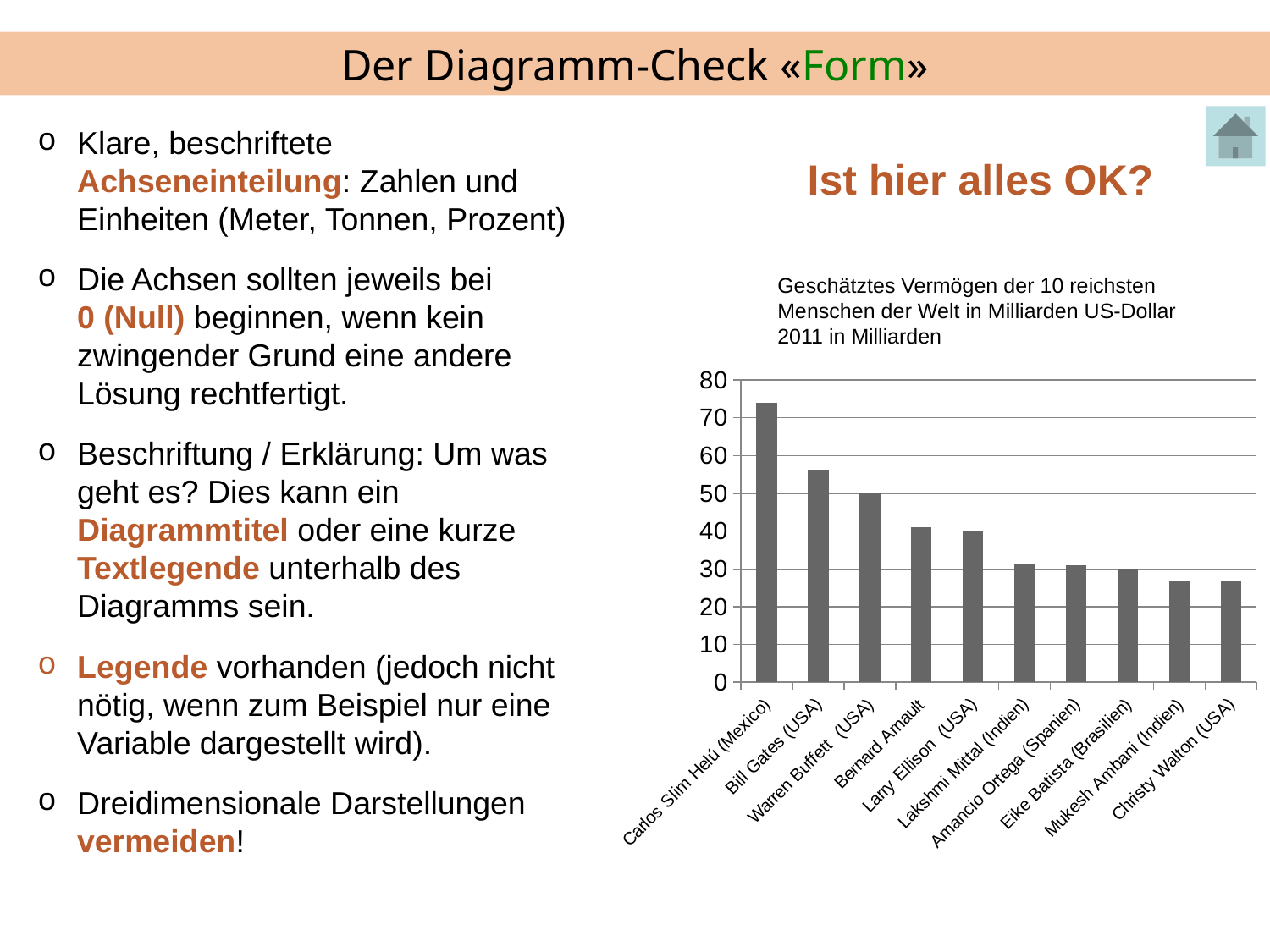
What is the highest value shown on the vertical axis of the chart? 80 Which is larger, the value for Bill Gates (USA) or the value for Warren Buffett (USA)? Bill Gates (USA) Is the value for Bill Gates (USA) greater or less than 60? less What kind of chart is shown on the slide? bar chart Is the value for Bernard Arnault greater or less than 50? less How many people (categories) are shown in the chart? 10 Is the value for Eike Batista (Brasilien) greater or less than 40? less Which is larger, the value for Larry Ellison (USA) or the value for Lakshmi Mittal (Indien)? Larry Ellison (USA) Which person has the highest value in the chart? Carlos Slim Helú (Mexico) Do the values rise or fall from left to right along the x axis? fall